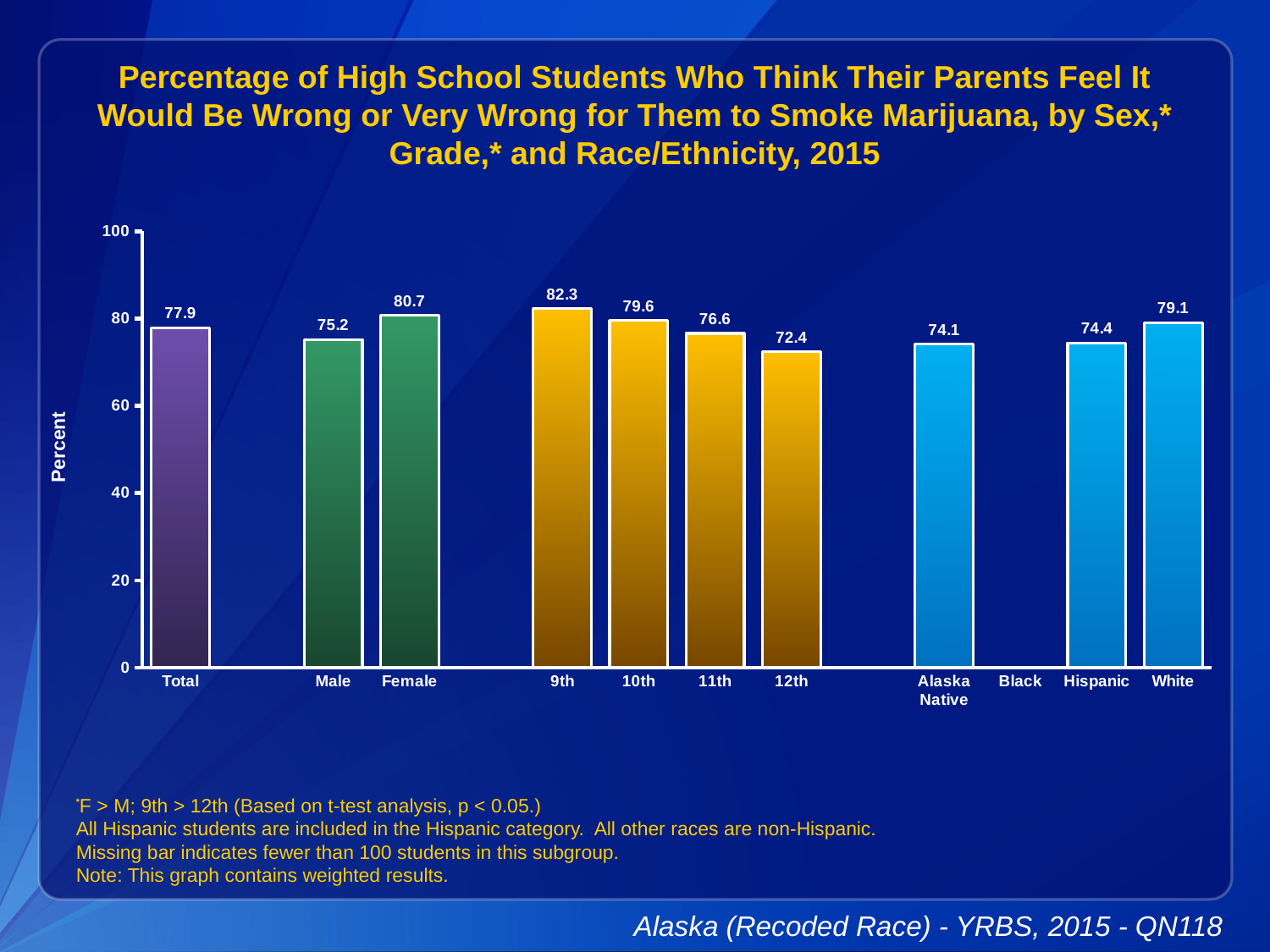
What is the value for 12th grade? 72.4 Which category has the highest value? 9th What kind of chart is shown? bar chart Which category with a bar has the lowest value? 12th What is the difference between the Female and Male values? 5.5 Is the value for 11th grade greater or less than 80? less What is the value for Total? 77.9 Which is larger, the value for White or the value for Hispanic? White What is the value for Female? 80.7 Do the values fall or rise from 9th grade to 12th grade? fall How many categories are labelled on the x axis? 11 What is the value for Alaska Native? 74.1